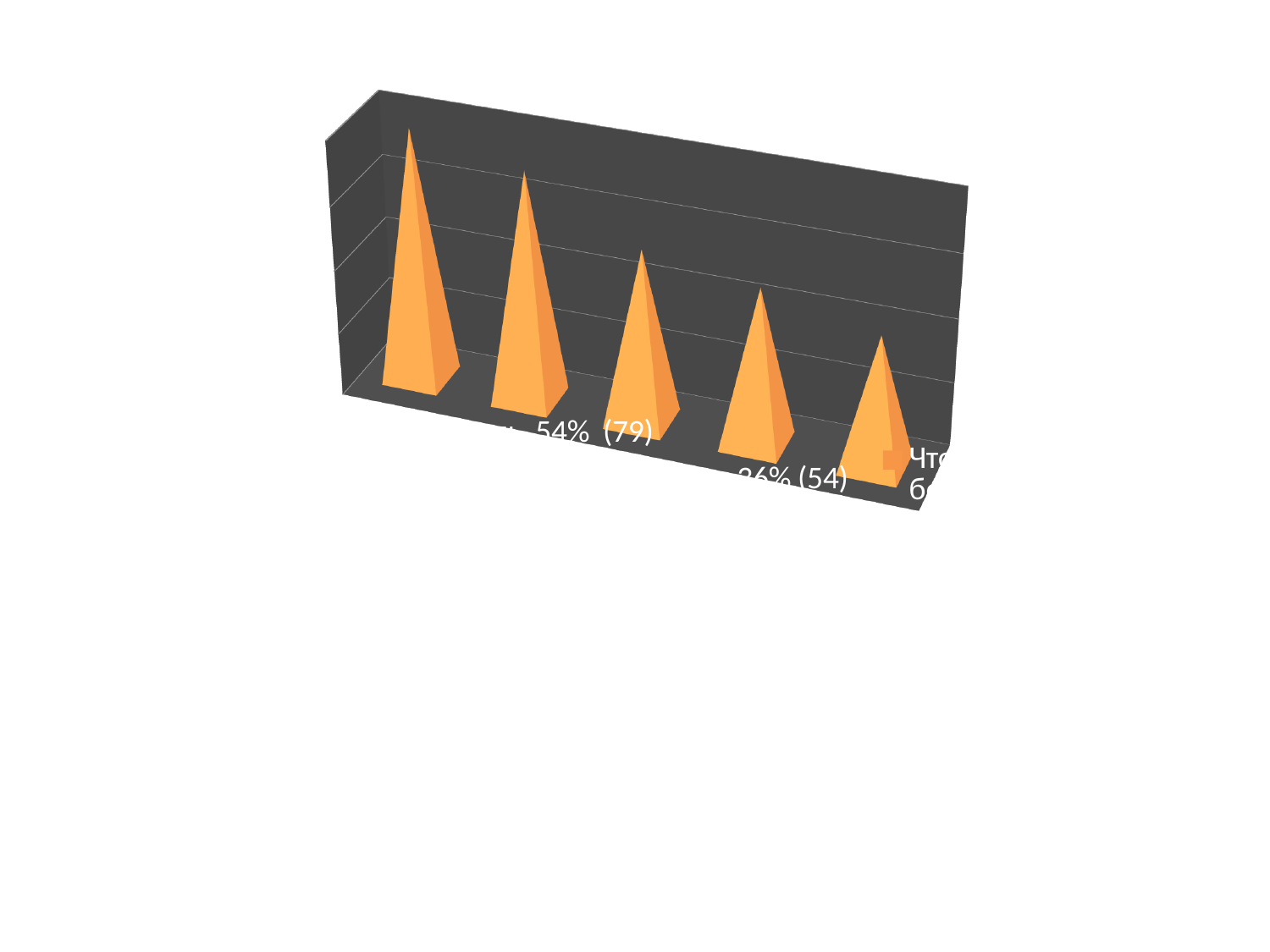
Which bar is the tallest in the chart, the leftmost or the rightmost? leftmost Is the second bar from the left taller or shorter than the fourth bar from the left? taller Which bar is the shortest in the chart, the leftmost or the rightmost? rightmost What colour are the bars in the chart? orange What kind of chart is shown on the slide? bar chart How many bars are plotted in the chart? 5 Do the bar values rise or fall from left to right across the chart? fall